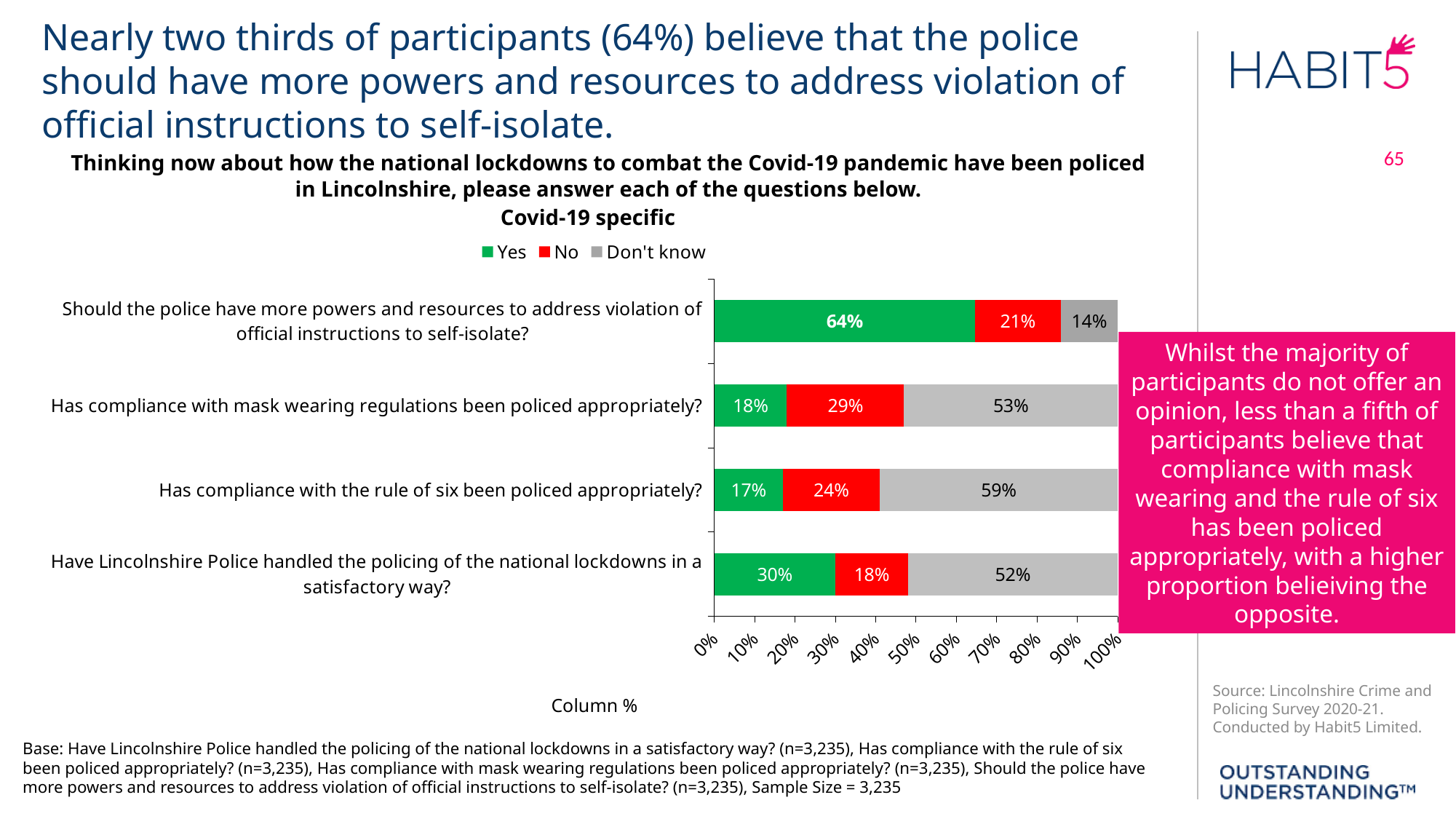
What type of chart is shown on the slide? Stacked bar chart What percentage answered Don't know to whether compliance with mask wearing regulations has been policed appropriately? 53% What is the difference between the Don't know percentages for the rule of six question and the mask wearing question? 6% What percentage of participants answered Yes to whether the police should have more powers and resources to address violation of official instructions to self-isolate? 64% Which question has the highest Yes percentage? Should the police have more powers and resources to address violation of official instructions to self-isolate? Which colour represents the Don't know responses in the chart? Grey Which question has the lowest Yes percentage? Has compliance with the rule of six been policed appropriately? How many series does the legend list? 3 How many questions (categories) are shown in the chart? 4 What percentage answered No to whether compliance with the rule of six has been policed appropriately? 24% Which is larger: the No percentage for the mask wearing question or the No percentage for the national lockdowns question? The No percentage for the mask wearing question What percentage answered Yes to whether Lincolnshire Police have handled the policing of the national lockdowns in a satisfactory way? 30%